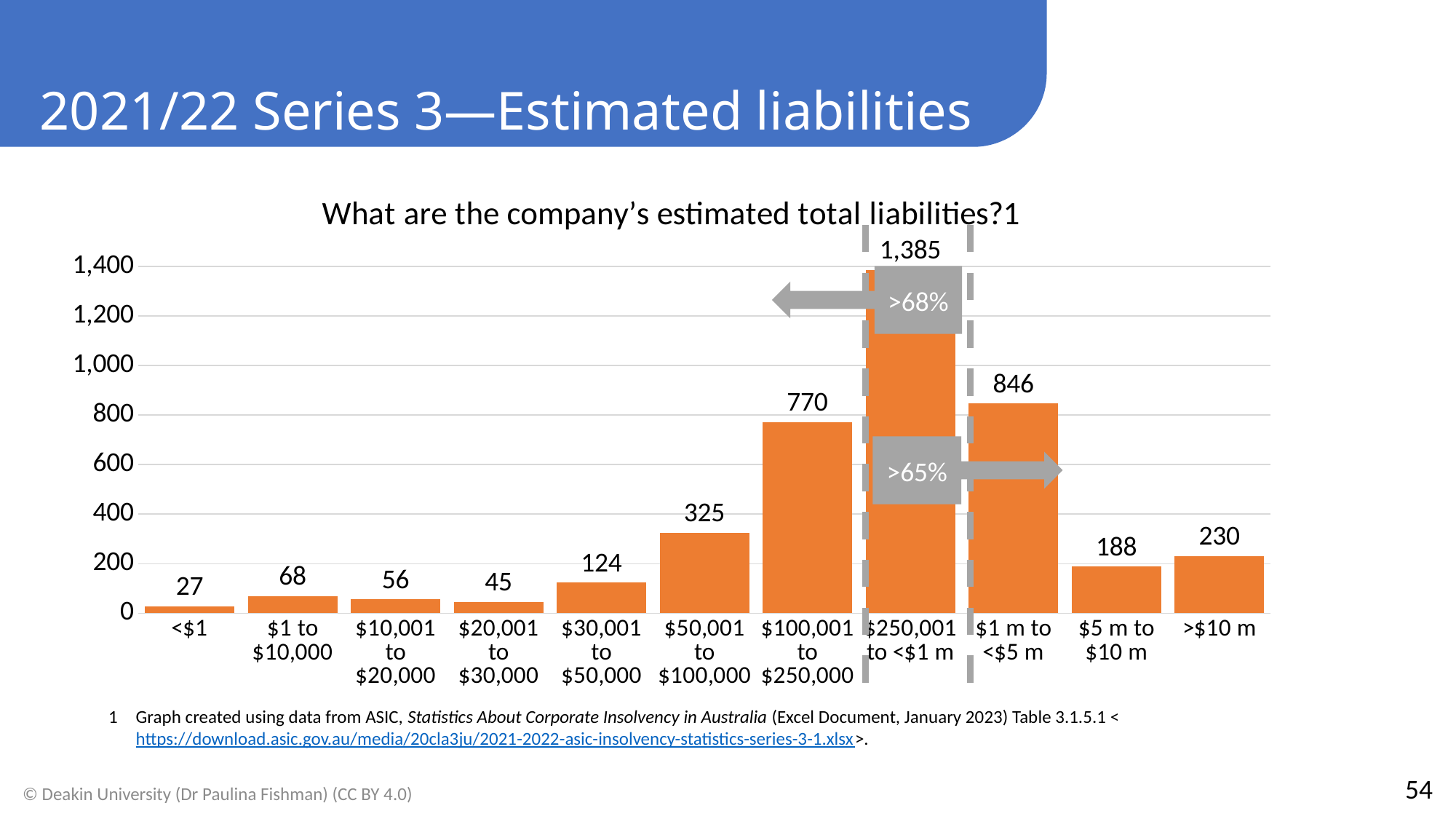
What is the value for the $250,001 to <$1 m category? 1,385 What is the value for the $100,001 to $250,000 category? 770 What is the difference between the values for $250,001 to <$1 m and $1 m to <$5 m? 539 What is the difference between the values for $5 m to $10 m and >$10 m? 42 Which category has the highest value? $250,001 to <$1 m What is the title of the chart? What are the company's estimated total liabilities?1 What is the value for the >$10 m category? 230 How many categories are shown on the x axis? 11 Is the value for $50,001 to $100,000 greater or less than 400? less Which is larger, the value for $10,001 to $20,000 or the value for $20,001 to $30,000? $10,001 to $20,000 Which category has the lowest value? <$1 What kind of chart is shown on the slide? bar chart